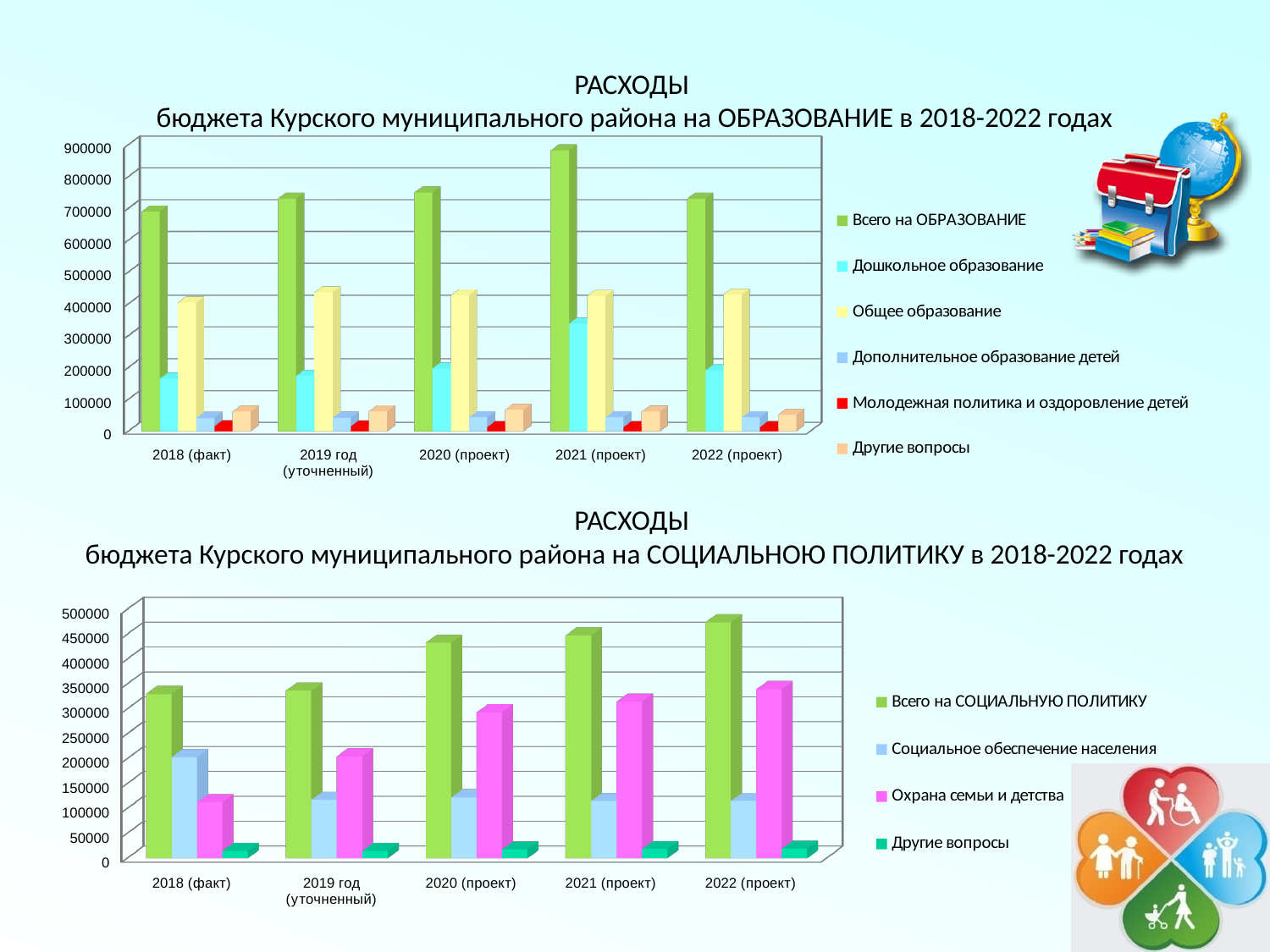
In the top chart (expenses on education), is the value for 'Всего на ОБРАЗОВАНИЕ' in 2021 (проект) greater or less than 800000? greater In the top chart (expenses on education), which year has the highest value for 'Всего на ОБРАЗОВАНИЕ'? 2021 (проект) In the bottom chart (expenses on social policy), which year has the highest value for 'Социальное обеспечение населения'? 2018 (факт) In the top chart (expenses on education), is the value for 'Дошкольное образование' in 2021 (проект) greater or less than 300000? greater In the top chart (expenses on education), how many series does the legend list? 6 In the bottom chart (expenses on social policy), is the value for 'Всего на СОЦИАЛЬНУЮ ПОЛИТИКУ' in 2022 (проект) greater or less than 450000? greater What kind of chart is the bottom chart (expenses on social policy)? bar chart In the bottom chart (expenses on social policy), which year has the highest value for 'Всего на СОЦИАЛЬНУЮ ПОЛИТИКУ'? 2022 (проект) In the bottom chart (expenses on social policy), how many year categories are shown on the x axis? 5 In the bottom chart (expenses on social policy), do the values for 'Охрана семьи и детства' rise or fall from 2018 to 2022? rise In the top chart (expenses on education), which is larger in 2018 (факт): 'Общее образование' or 'Дошкольное образование'? Общее образование